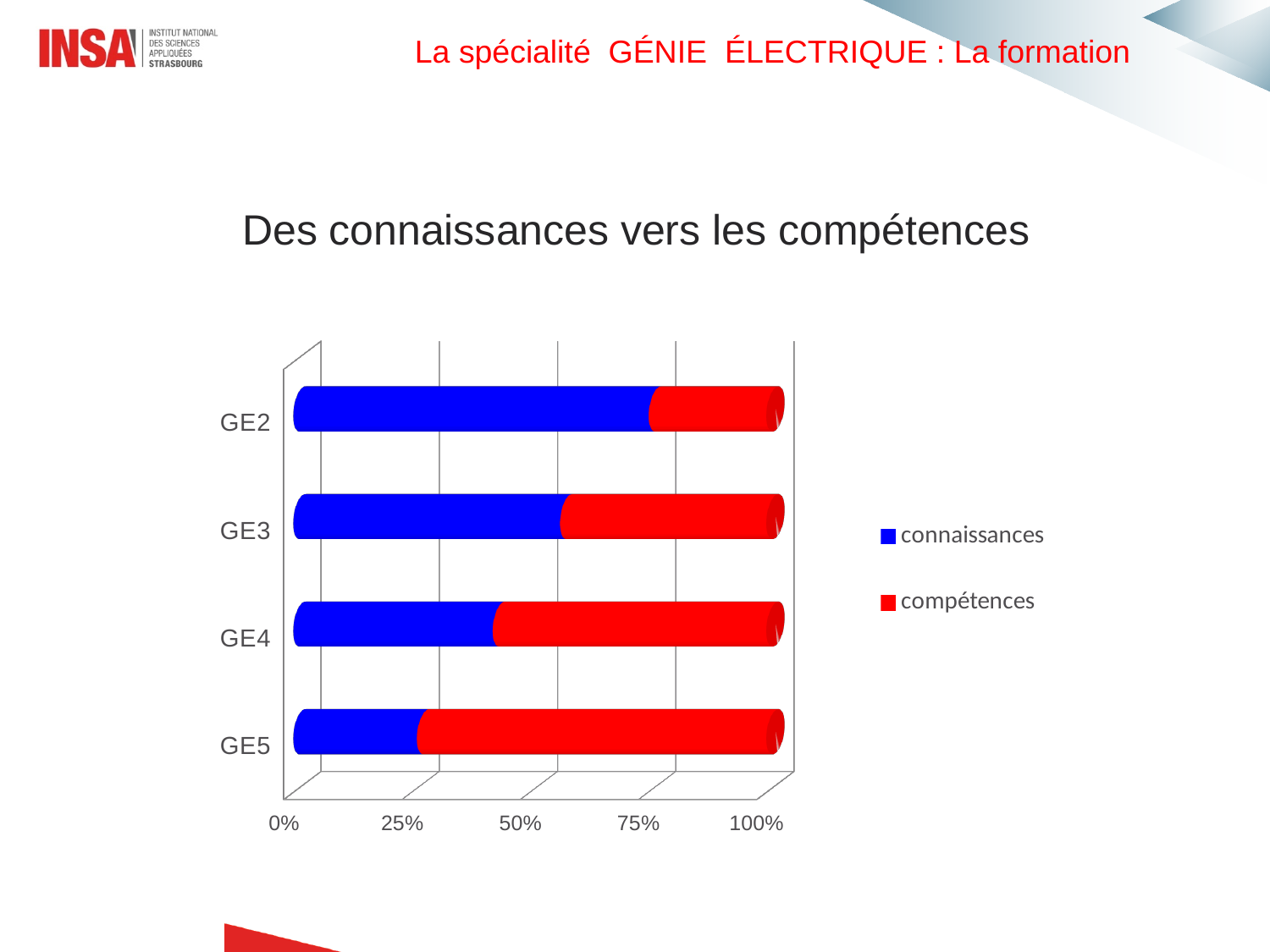
Which colour represents the compétences series in the chart? Red Is the connaissances share for GE3 greater or less than 50%? greater Going from GE2 down to GE5, does the share of compétences rise or fall? rise Is the connaissances share for GE4 greater or less than 50%? less Which category has the smallest share of connaissances? GE5 Which category has the largest share of compétences? GE5 How many series does the chart legend list? 2 What kind of chart is shown on the slide? Stacked bar chart Which category has the largest share of connaissances? GE2 Is the compétences share for GE2 greater or less than 50%? less How many categories are shown on the vertical axis of the chart? 4 Which is larger: the connaissances share for GE2 or for GE5? GE2